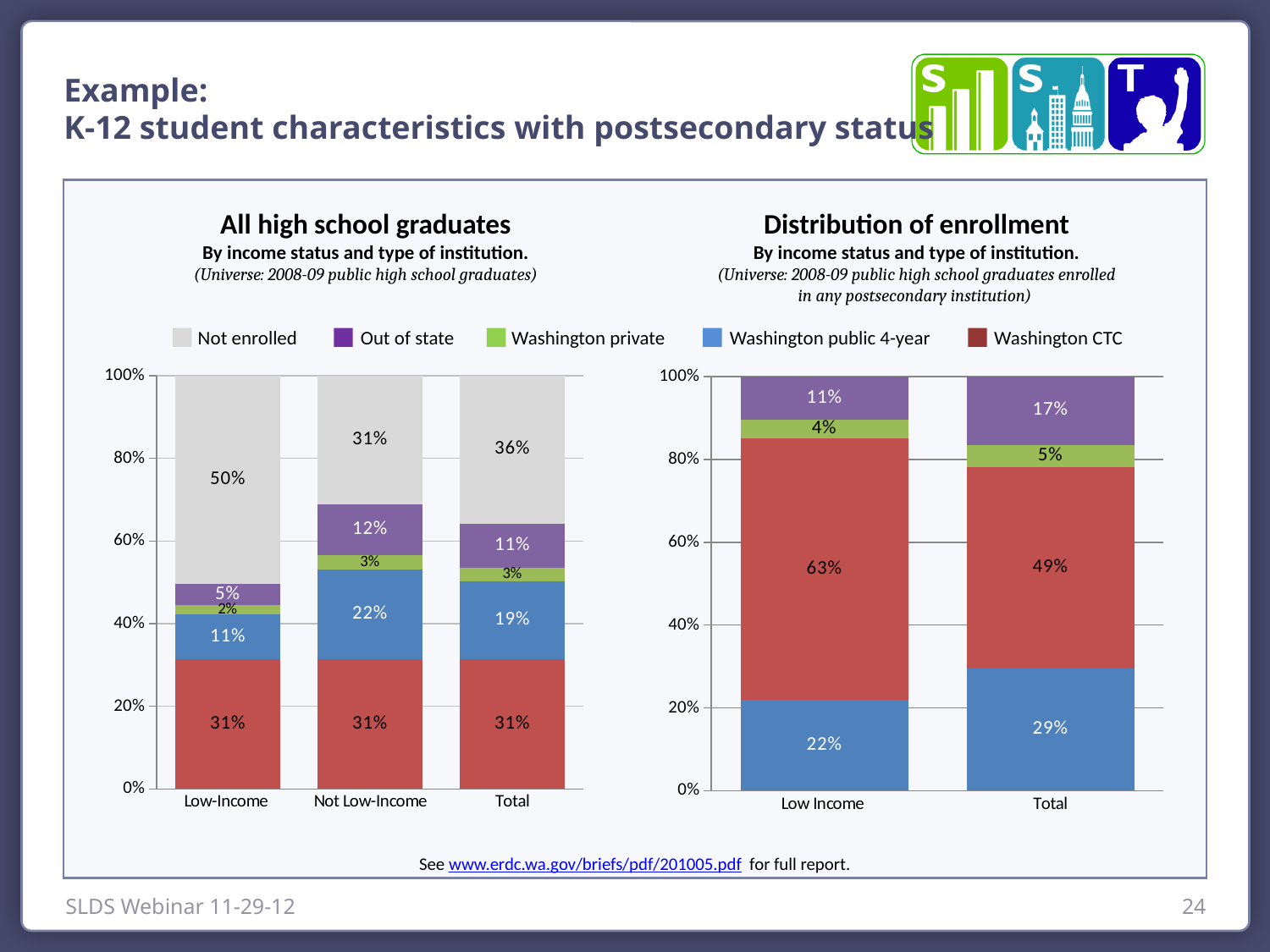
In the 'All high school graduates' chart, what is the difference between the Not enrolled percentages for Low-Income and Not Low-Income graduates? 19% In the 'All high school graduates' chart, what is the Washington public 4-year value for Not Low-Income graduates? 22% In the 'All high school graduates' chart, which category has the lowest Washington public 4-year percentage? Low-Income In the 'All high school graduates' chart, which category has the highest Not enrolled percentage? Low-Income In the 'Distribution of enrollment' chart, what is the Washington CTC share for Low Income students? 63% In the 'Distribution of enrollment' chart, what is the Out of state value for the Total bar? 17% In the 'Distribution of enrollment' chart, what is the difference between the Washington CTC values for Low Income and Total? 14% How many series does the legend list? 5 In the 'All high school graduates' chart, what percentage of Low-Income graduates were not enrolled? 50% In the 'Distribution of enrollment' chart, is the Washington public 4-year value larger for Low Income or for Total? Total What kind of chart is the 'Distribution of enrollment' chart? Stacked bar chart How many categories are shown on the x axis of the 'All high school graduates' chart? 3